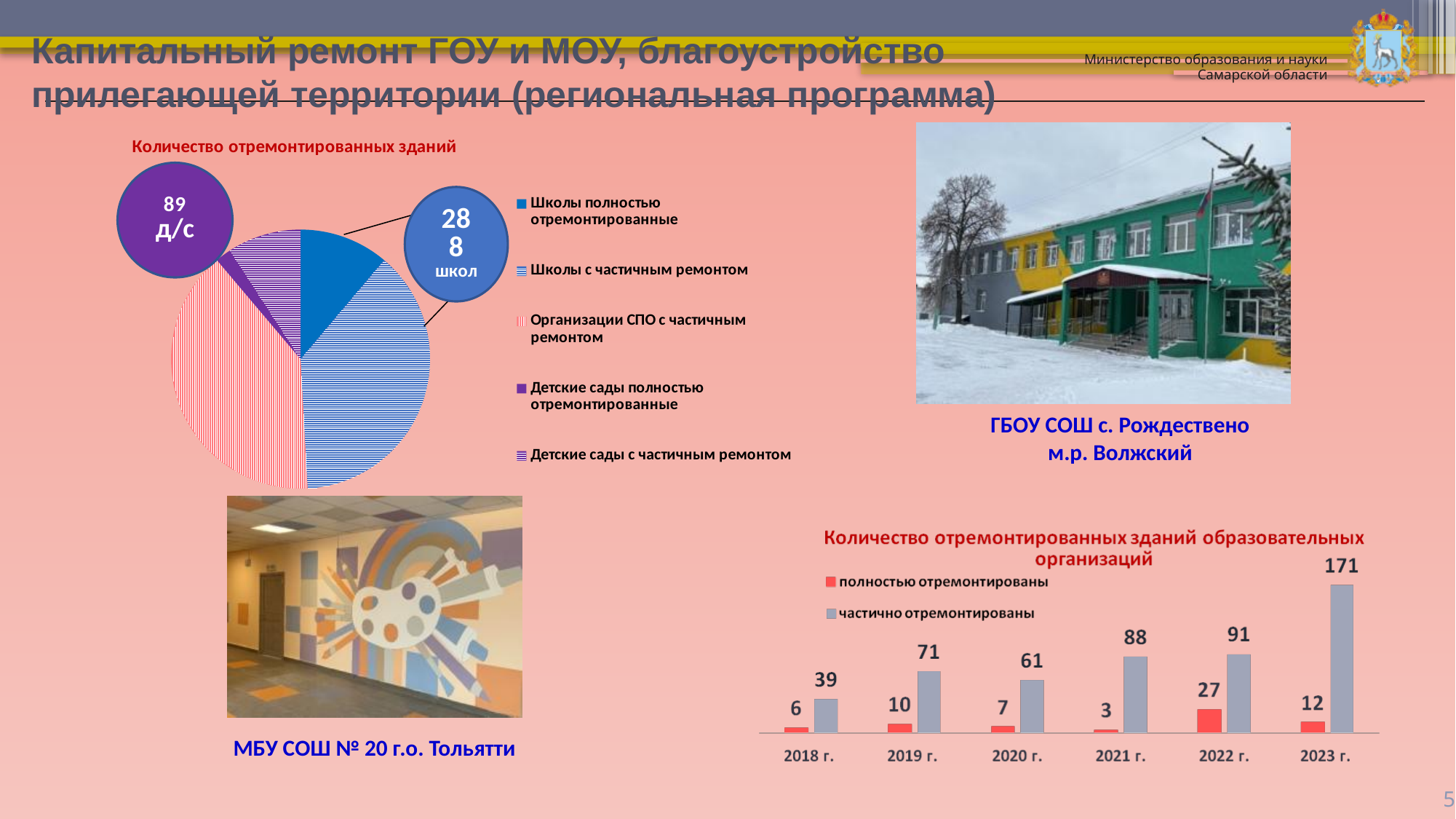
How many series does the legend of the bar chart 'Количество отремонтированных зданий образовательных организаций' list? 2 What kind of chart is 'Количество отремонтированных зданий образовательных организаций'? bar chart In the bar chart 'Количество отремонтированных зданий образовательных организаций', which year has the lowest value for 'полностью отремонтированы'? 2021 г. What kind of chart is 'Количество отремонтированных зданий' on the left of the slide? pie chart In the pie chart 'Количество отремонтированных зданий', which category has the largest slice? Организации СПО с частичным ремонтом In the bar chart 'Количество отремонтированных зданий образовательных организаций', which is larger: 'частично отремонтированы' in 2019 г. or in 2020 г.? 2019 г. In the bar chart 'Количество отремонтированных зданий образовательных организаций', what is the value for 'частично отремонтированы' in 2023 г.? 171 In the bar chart 'Количество отремонтированных зданий образовательных организаций', which year has the highest value for 'частично отремонтированы'? 2023 г. How many years are shown on the x axis of the bar chart 'Количество отремонтированных зданий образовательных организаций'? 6 How many categories does the legend of the pie chart 'Количество отремонтированных зданий' list? 5 In the bar chart 'Количество отремонтированных зданий образовательных организаций', what is the difference between 'частично отремонтированы' in 2023 г. and in 2022 г.? 80 In the bar chart 'Количество отремонтированных зданий образовательных организаций', what is the value for 'полностью отремонтированы' in 2022 г.? 27